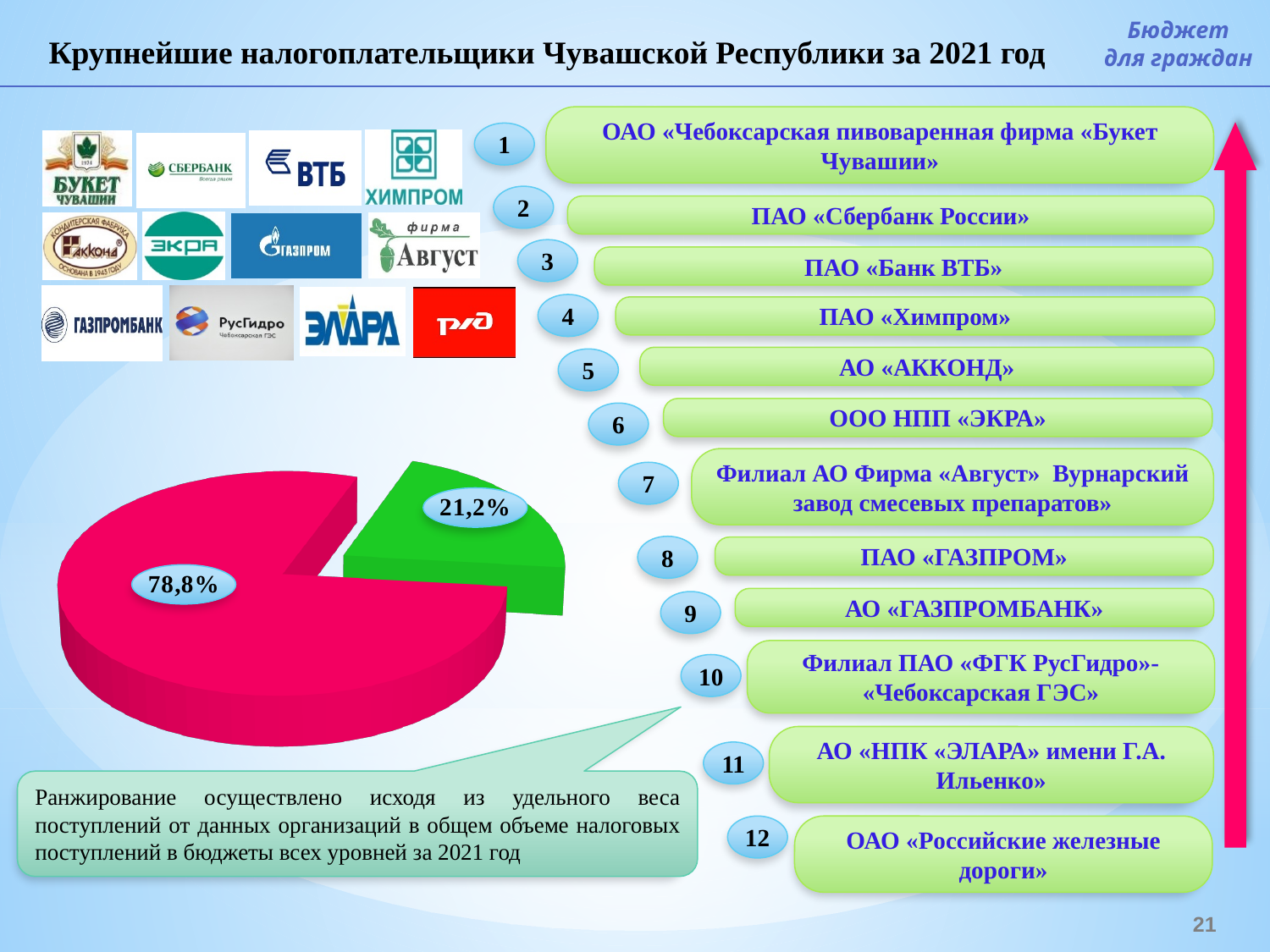
What kind of chart is shown on the left side of the slide? pie chart Is the value of the green slice of the pie chart greater or less than 25%? less What value is shown on the pink slice of the pie chart? 78,8% What is the difference between the pink slice and the green slice of the pie chart? 57,6% What do the two slices of the pie chart add up to? 100% Which slice of the pie chart is the smallest? the green slice (21,2%) Which is larger in the pie chart, the pink slice or the green slice? the pink slice What colour is the slice labelled 78,8% in the pie chart? pink Which slice of the pie chart is the largest? the pink slice (78,8%) What value is shown on the green slice of the pie chart? 21,2% What share of the pie does the green slice represent? 21,2% How many slices does the pie chart have? 2